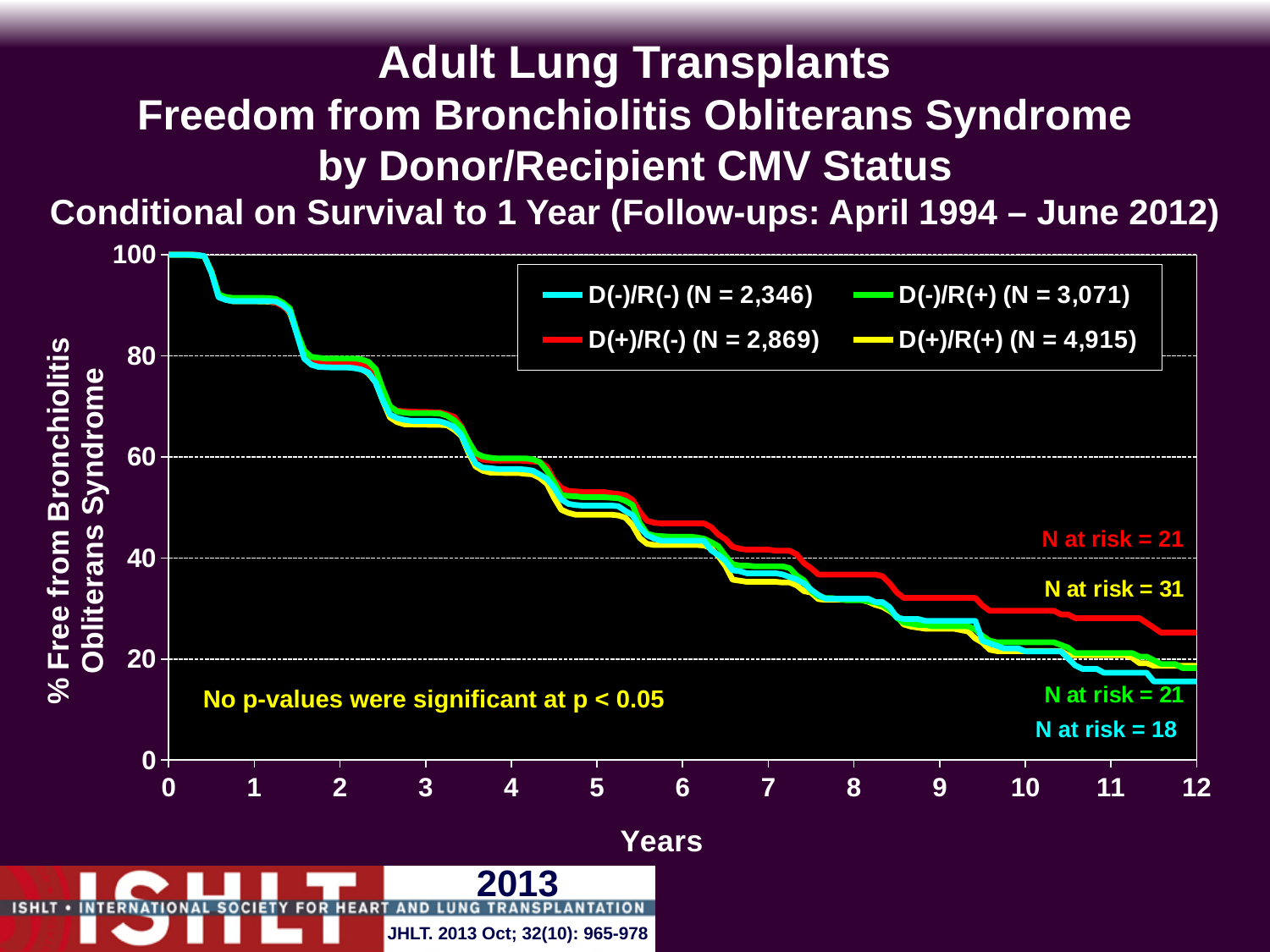
What is the label of the x axis? Years Is the value for the D(-)/R(-) line at 12 years greater or less than 20? less At 12 years, which line is higher: D(+)/R(-) or D(-)/R(-)? D(+)/R(-) How many series does the legend list? 4 Do the curves rise or fall as years increase? fall Is the value for the D(+)/R(-) line at 12 years greater or less than 20? greater What is the N at risk shown for the red D(+)/R(-) line at the end of follow-up? 21 Which group has the largest N in the legend? D(+)/R(+) What is the N for the D(+)/R(+) group shown in the legend? 4,915 What is the N at risk shown for the cyan D(-)/R(-) line at the end of follow-up? 18 What is the N for the D(-)/R(-) group shown in the legend? 2,346 What kind of chart is shown on the slide? line chart